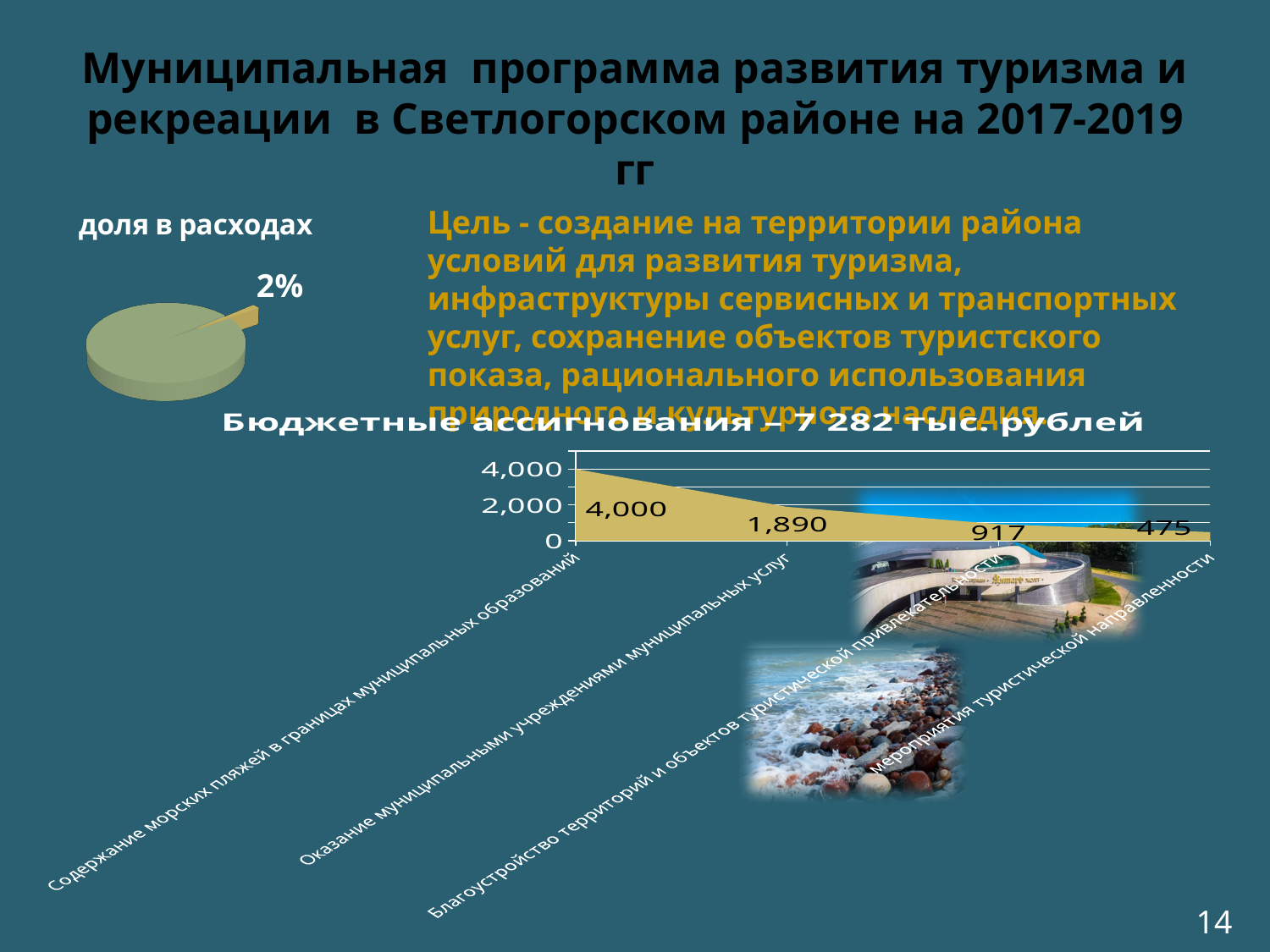
Do the values in the chart titled 'Бюджетные ассигнования – 7 282 тыс. рублей' rise or fall from left to right along the x axis? fall In the chart titled 'Бюджетные ассигнования – 7 282 тыс. рублей', which is larger: the value for 'Благоустройство территорий и объектов туристической привлекательности' or for 'мероприятия туристической направленности'? Благоустройство территорий и объектов туристической привлекательности In the pie chart titled 'доля в расходах', what share is shown for the highlighted slice? 2% In the chart titled 'Бюджетные ассигнования – 7 282 тыс. рублей', what is the value for 'Благоустройство территорий и объектов туристической привлекательности'? 917 In the chart titled 'Бюджетные ассигнования – 7 282 тыс. рублей', which category has the lowest value? мероприятия туристической направленности In the chart titled 'Бюджетные ассигнования – 7 282 тыс. рублей', which category has the highest value? Содержание морских пляжей в границах муниципальных образований In the chart titled 'Бюджетные ассигнования – 7 282 тыс. рублей', what is the value for 'мероприятия туристической направленности'? 475 What kind of chart is the one titled 'Бюджетные ассигнования – 7 282 тыс. рублей'? area chart In the chart titled 'Бюджетные ассигнования – 7 282 тыс. рублей', what is the value for 'Содержание морских пляжей в границах муниципальных образований'? 4,000 How many categories are plotted in the chart titled 'Бюджетные ассигнования – 7 282 тыс. рублей'? 4 In the chart titled 'Бюджетные ассигнования – 7 282 тыс. рублей', what is the value for 'Оказание муниципальными учреждениями муниципальных услуг'? 1,890 In the chart titled 'Бюджетные ассигнования – 7 282 тыс. рублей', what is the difference between the values for 'Содержание морских пляжей в границах муниципальных образований' and 'Оказание муниципальными учреждениями муниципальных услуг'? 2,110